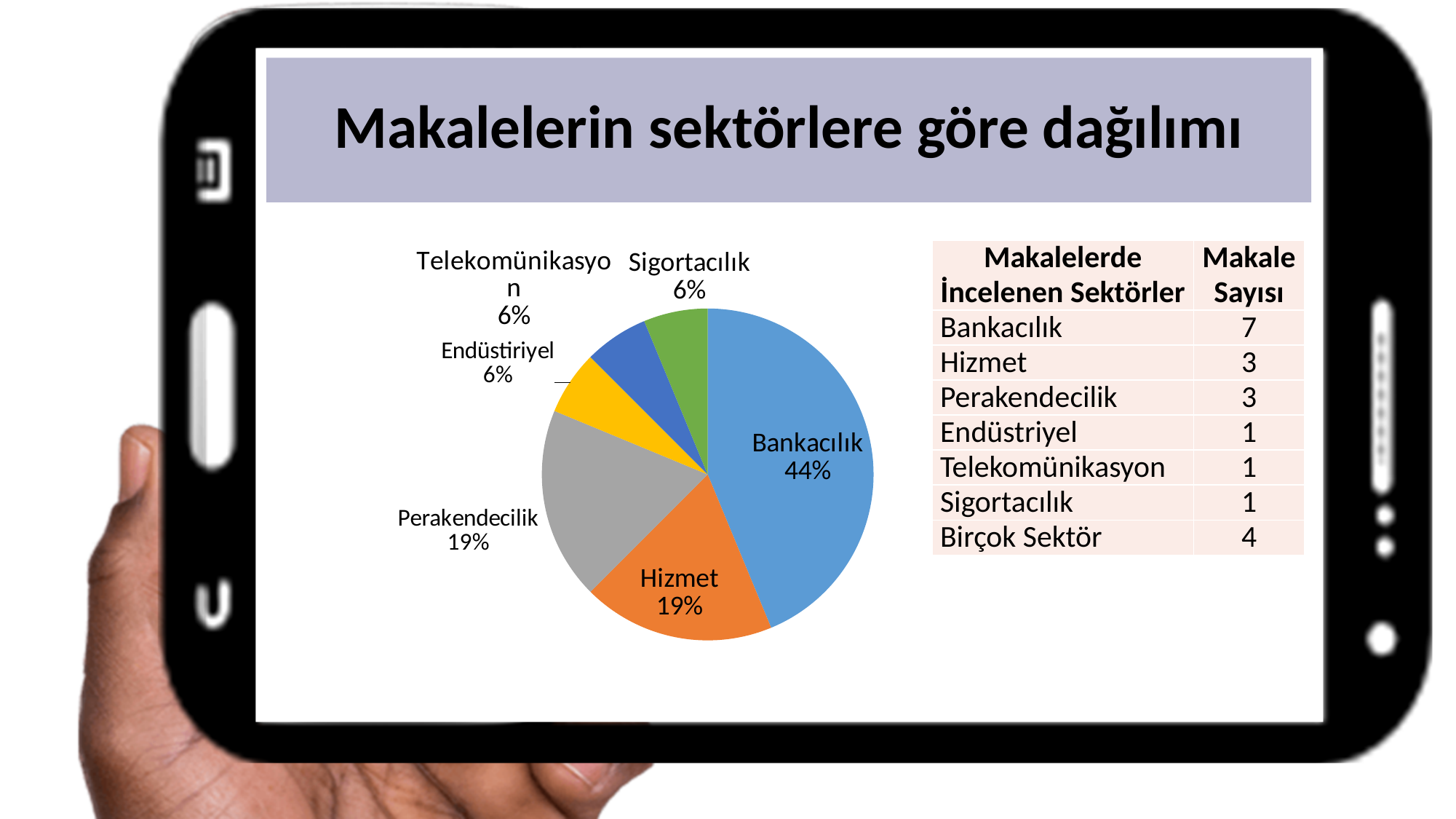
What share of the pie does Perakendecilik have? 19% What share of the pie does Sigortacılık have? 6% What kind of chart is shown on the slide? Pie chart What share of the pie does Telekomünikasyon have? 6% What is the title of the slide containing the pie chart? Makalelerin sektörlere göre dağılımı Which slice is larger, Perakendecilik or Sigortacılık? Perakendecilik Which sector has the largest slice of the pie? Bankacılık How many slices does the pie chart have? 6 What colour is the Bankacılık slice of the pie? Blue What is the difference in percentage points between the Bankacılık slice and the Hizmet slice? 25